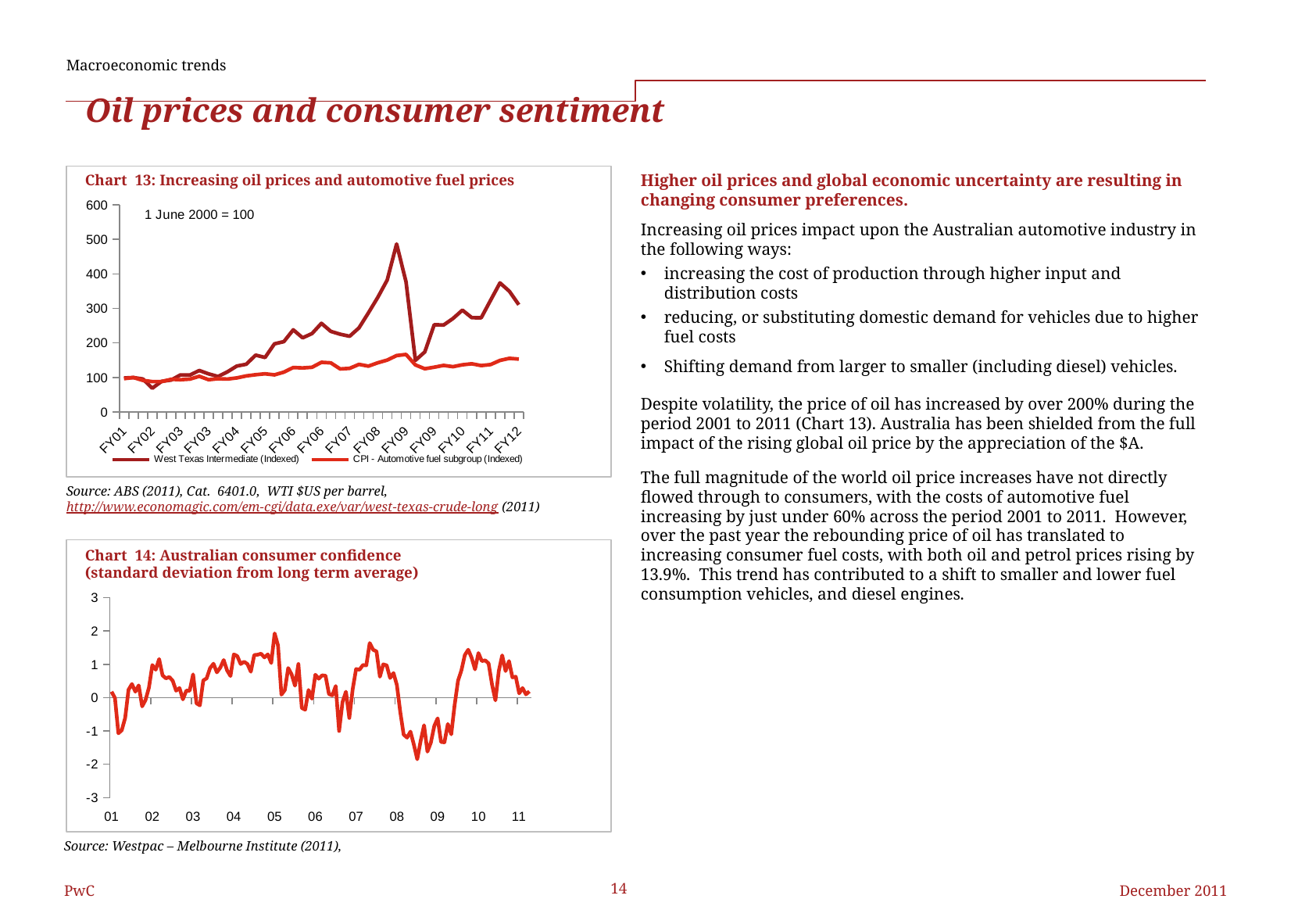
How many series does the legend of Chart 13 list? 2 What kind of chart is Chart 13: Increasing oil prices and automotive fuel prices? Line chart In Chart 13, is the value of CPI - Automotive fuel subgroup (Indexed) at FY12 greater or less than 200? less In Chart 13, which series is higher at FY12: West Texas Intermediate (Indexed) or CPI - Automotive fuel subgroup (Indexed)? West Texas Intermediate (Indexed) What are the two series named in the legend of Chart 13? West Texas Intermediate (Indexed) and CPI - Automotive fuel subgroup (Indexed) In Chart 13, what base is stated for the index? 1 June 2000 = 100 What kind of chart is Chart 14: Australian consumer confidence? Line chart In Chart 14, is the highest value of consumer confidence, reached around 05, greater or less than 1? greater How many year labels are shown on the x axis of Chart 14? 11 In Chart 13, does the CPI - Automotive fuel subgroup (Indexed) series generally rise or fall from FY01 to FY12? Rise In Chart 14, is the lowest value of consumer confidence, reached around 08-09, greater or less than -1? less